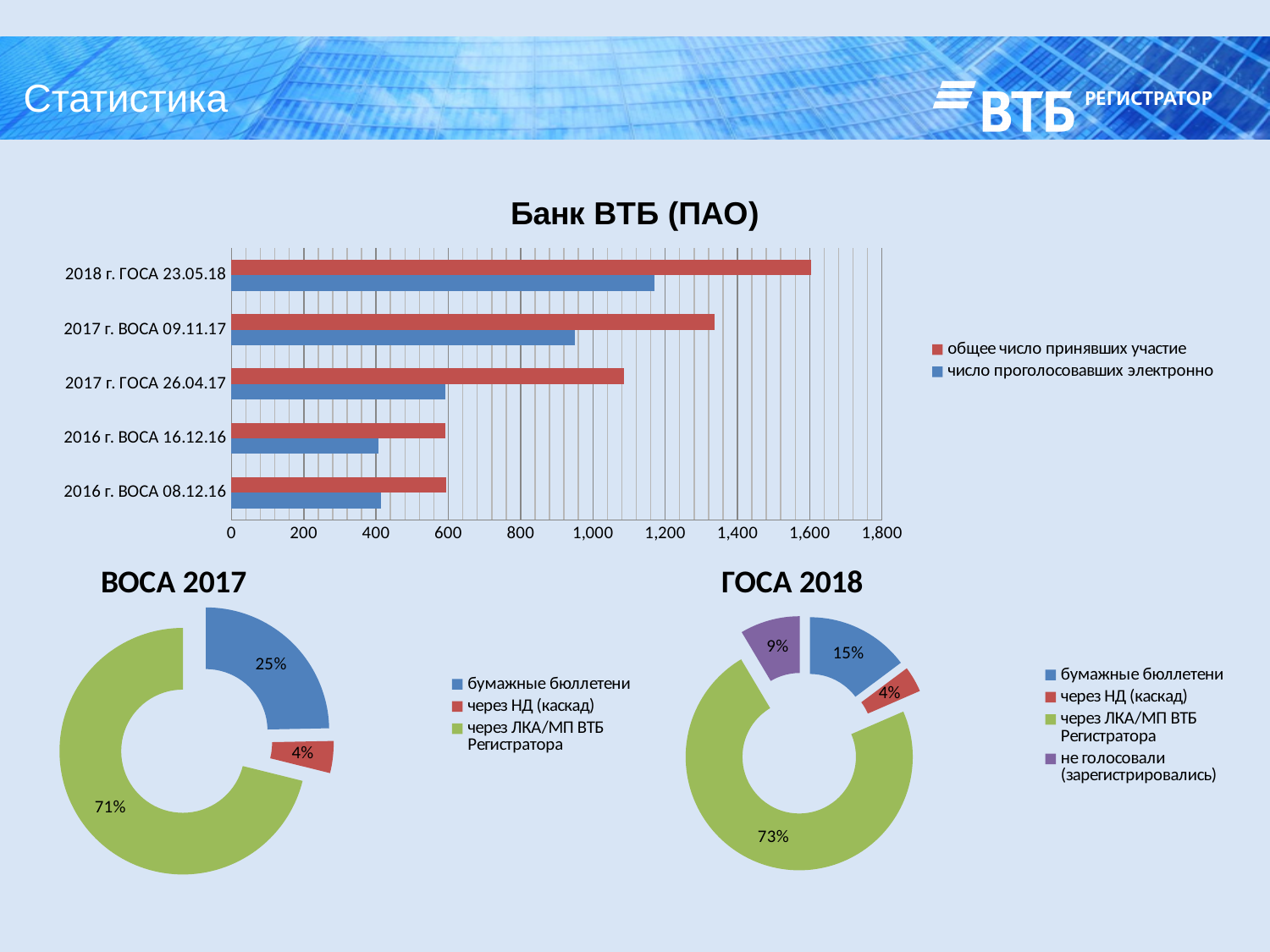
On the "Банк ВТБ (ПАО)" chart, which meeting has the highest value for "общее число принявших участие"? 2018 г. ГОСА 23.05.18 On the "Банк ВТБ (ПАО)" chart, is the value of "общее число принявших участие" for 2018 г. ГОСА 23.05.18 greater or less than 1,400? greater On the "Банк ВТБ (ПАО)" chart, which has the larger "общее число принявших участие": 2017 г. ГОСА 26.04.17 or 2017 г. ВОСА 09.11.17? 2017 г. ВОСА 09.11.17 How many meetings (categories) are shown on the "Банк ВТБ (ПАО)" chart? 5 On the "Банк ВТБ (ПАО)" chart, is the value of "число проголосовавших электронно" for 2017 г. ВОСА 09.11.17 greater or less than 800? greater On the "ВОСА 2017" chart, which category has the largest share? через ЛКА/МП ВТБ Регистратора On the "ГОСА 2018" chart, what share is "не голосовали (зарегистрировались)"? 9% On the "ВОСА 2017" chart, what share is "бумажные бюллетени"? 25% How many entries does the legend of the "ГОСА 2018" chart list? 4 What kind of chart is the "Банк ВТБ (ПАО)" chart? bar chart On the "ГОСА 2018" chart, what is the difference in percentage points between "через ЛКА/МП ВТБ Регистратора" and "бумажные бюллетени"? 58 How many series does the legend of the "Банк ВТБ (ПАО)" chart list? 2